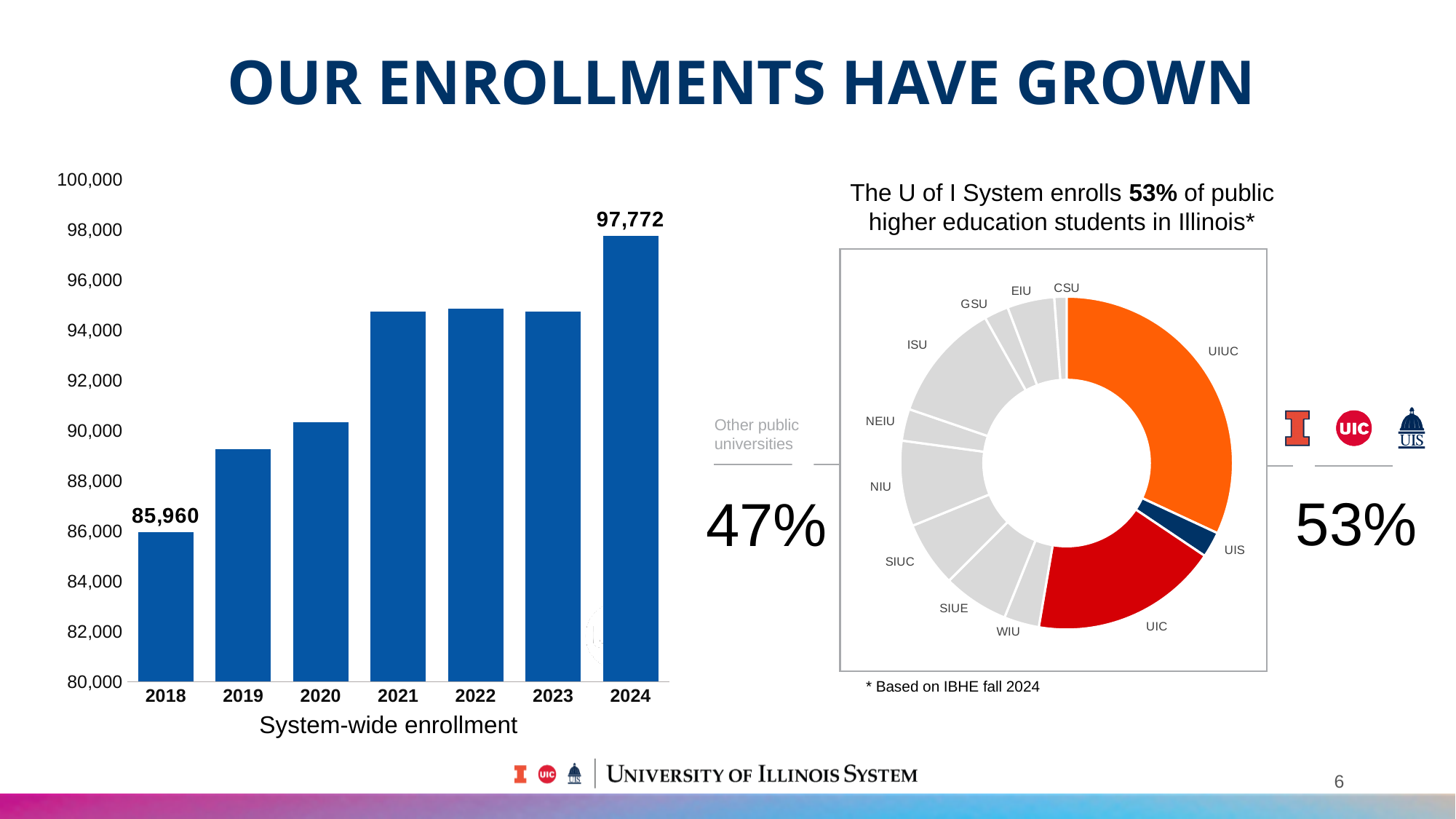
In the donut chart on the right, what share of public higher education students in Illinois does the U of I System enroll? 53% In the System-wide enrollment bar chart, by how much did enrollment grow from 2018 to 2024? 11,812 In the System-wide enrollment bar chart, is the value for 2021 greater or less than 94,000? greater In the System-wide enrollment bar chart, which year has the highest enrollment? 2024 In the System-wide enrollment bar chart, which year has the lowest enrollment? 2018 In the System-wide enrollment bar chart, what was the enrollment in 2018? 85,960 In the System-wide enrollment bar chart, which year has the larger enrollment, 2019 or 2020? 2020 What kind of chart is the System-wide enrollment chart on the left? bar chart In the System-wide enrollment bar chart, is the value for 2020 greater or less than 92,000? less In the donut chart on the right, what share of public higher education students in Illinois is enrolled at other public universities? 47% How many years are shown in the System-wide enrollment bar chart? 7 In the System-wide enrollment bar chart, what was the enrollment in 2024? 97,772